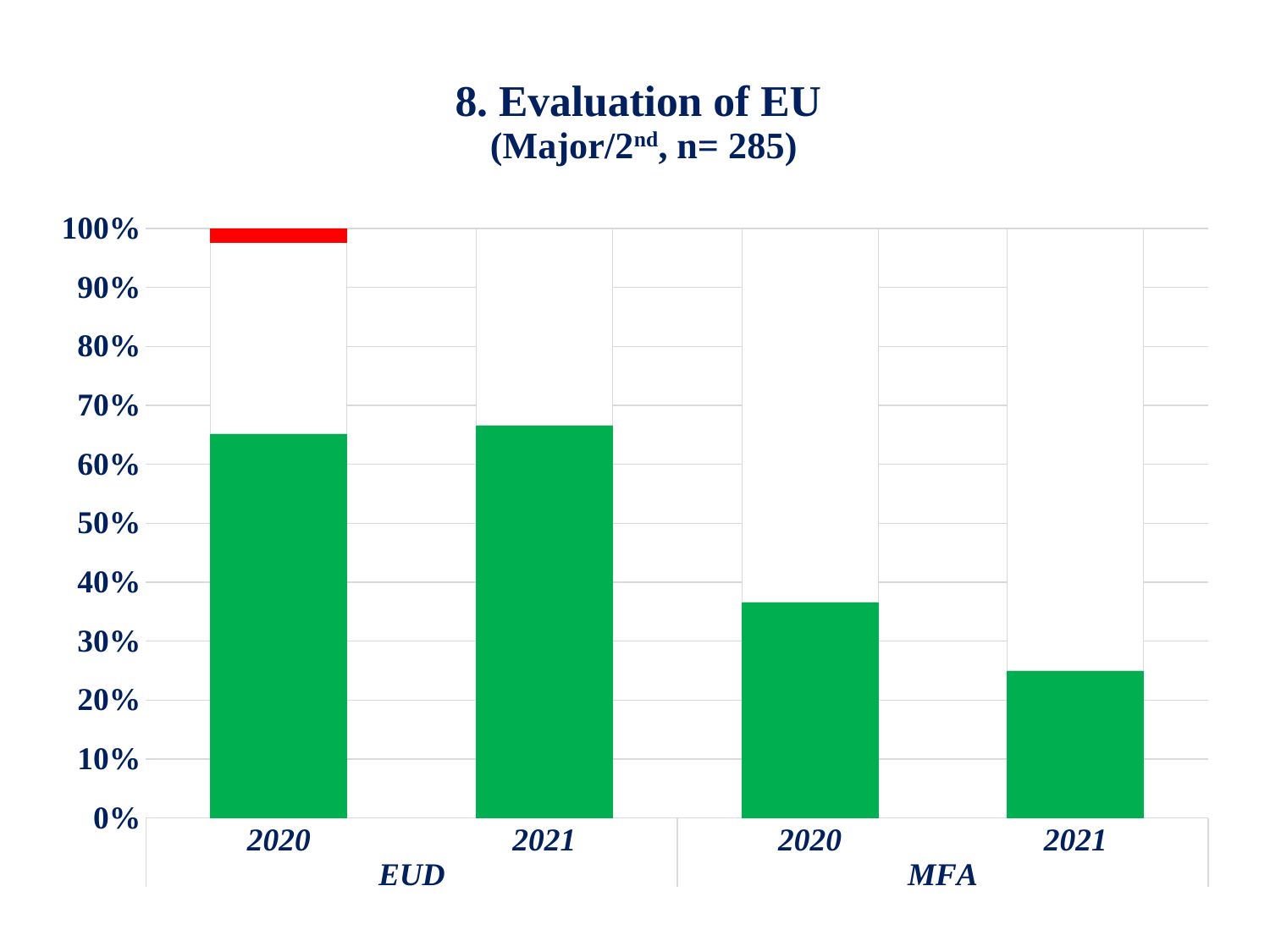
Which has the larger green segment, MFA 2020 or MFA 2021? MFA 2020 Which bar has the smallest green segment? MFA 2021 Which has the larger green segment, EUD 2020 or MFA 2020? EUD 2020 Which two groups are labelled on the x axis? EUD and MFA What is the title of the chart? 8. Evaluation of EU (Major/2nd, n= 285) How many bars are plotted in the chart? 4 What kind of chart is shown on the slide? Stacked bar chart Is the green segment for EUD 2021 greater or less than 70%? less Is the green segment for EUD 2020 greater or less than 60%? greater Within the MFA group, does the green segment rise or fall from 2020 to 2021? fall Is the green segment for MFA 2020 greater or less than 40%? less